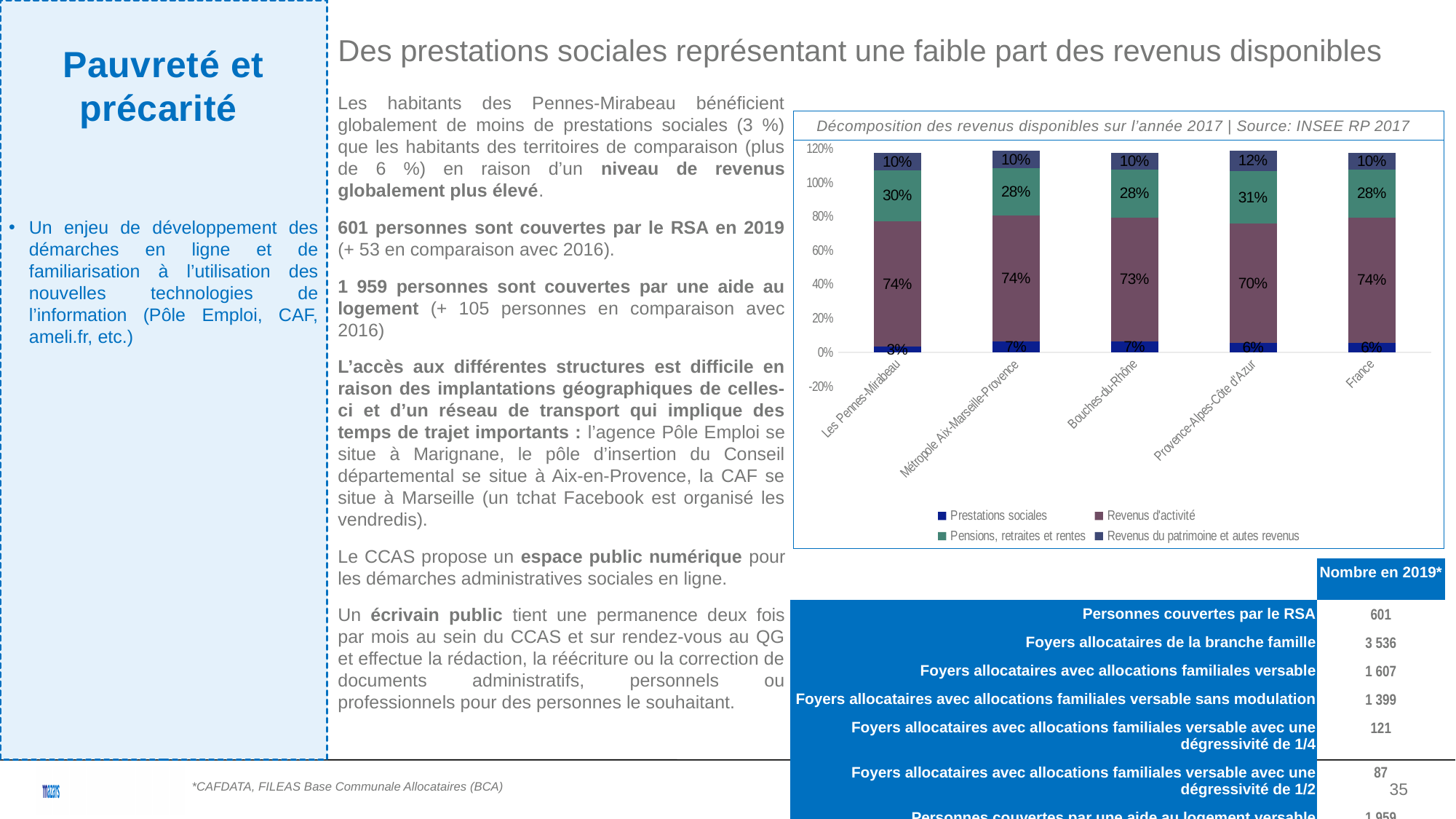
What is the value of Prestations sociales for Les Pennes-Mirabeau? 3% What is the difference in Prestations sociales between Métropole Aix-Marseille-Provence and Les Pennes-Mirabeau? 4 percentage points Which territory has the lowest share of Prestations sociales? Les Pennes-Mirabeau What is the value of Revenus d'activité for Provence-Alpes-Côte d'Azur? 70% Which territory has the highest share of Pensions, retraites et rentes? Provence-Alpes-Côte d'Azur How many series does the chart legend list? 4 What is the value of Revenus du patrimoine et autres revenus for Provence-Alpes-Côte d'Azur? 12% Which territory has the lowest share of Revenus d'activité? Provence-Alpes-Côte d'Azur How many territories are shown on the x axis of the chart? 5 Which has a larger share of Pensions, retraites et rentes: Les Pennes-Mirabeau or France? Les Pennes-Mirabeau What kind of chart is shown on the slide? Stacked bar chart What is the value of Pensions, retraites et rentes for Provence-Alpes-Côte d'Azur? 31%